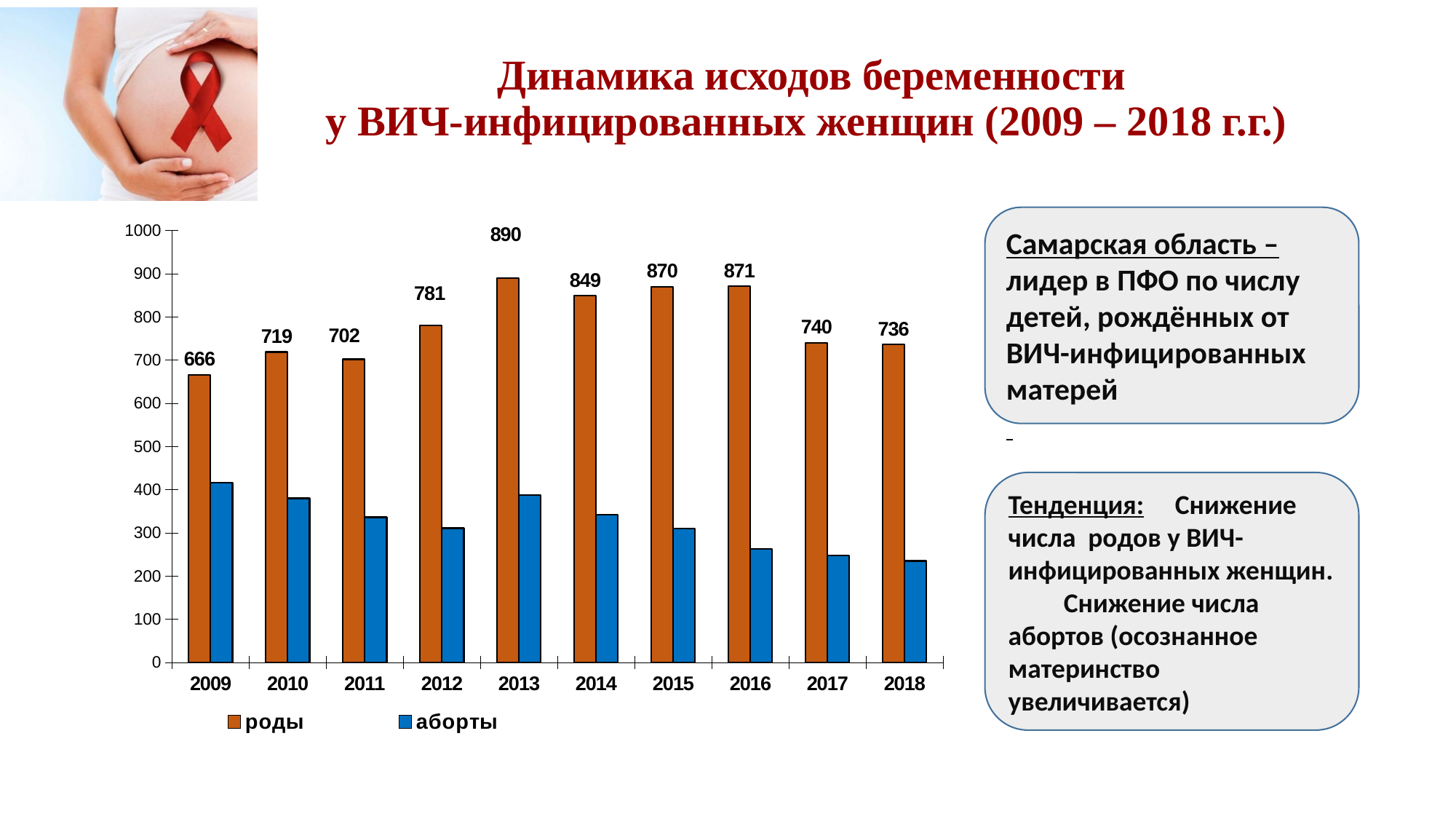
What is the value for роды in 2009? 666 Is the value for аборты in 2018 greater or less than 300? less What kind of chart is shown on the slide? bar chart In which year is the value for роды the lowest? 2009 How many series does the legend list? 2 Is the value for аборты in 2009 greater or less than 300? greater What is the difference between the роды values for 2013 and 2009? 224 In which year is the value for роды the highest? 2013 What is the value for роды in 2013? 890 Which year has the larger роды value, 2012 or 2017? 2012 What is the value for роды in 2018? 736 How many years are shown on the x axis of the chart? 10